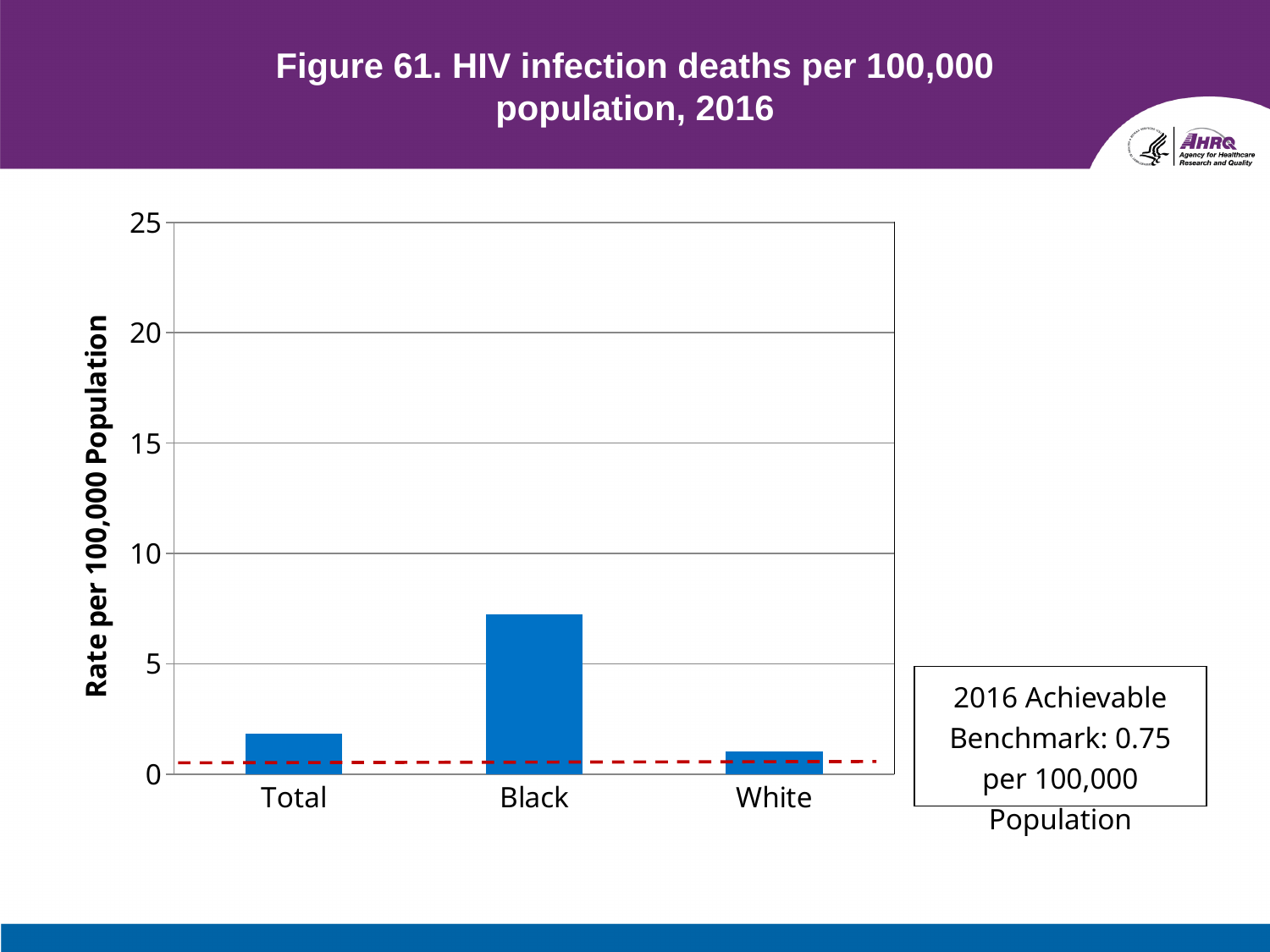
What is the label on the y axis of the chart? Rate per 100,000 Population Which category has the lowest HIV infection death rate? White Is the value for Black greater or less than 10? less Which is larger, the rate for Black or the rate for Total? Black What is the 2016 achievable benchmark shown on the slide? 0.75 per 100,000 Population Which is larger, the rate for Black or the rate for White? Black Is the value for Total greater or less than 5? less Is the value for Black greater or less than 5? greater What kind of chart is shown on the slide? bar chart How many categories are plotted on the x axis? 3 Which category has the highest HIV infection death rate? Black